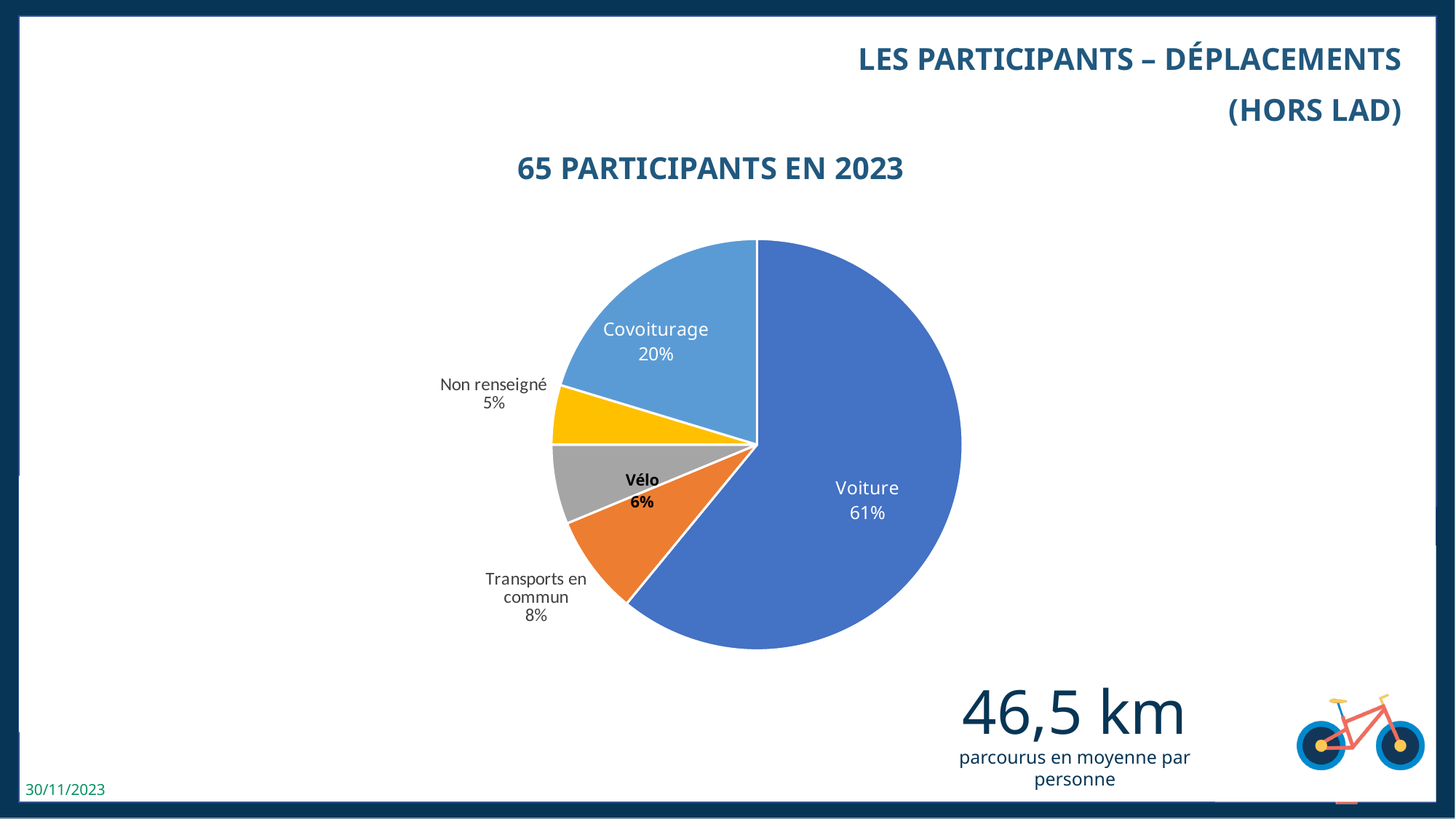
What share of participants used Covoiturage? 20% What share of participants travelled by Voiture? 61% What share of participants is labelled Non renseigné? 5% Which category has the smallest slice of the pie? Non renseigné What is the title shown above the pie chart? 65 PARTICIPANTS EN 2023 Which is larger, the share for Transports en commun or the share for Vélo? Transports en commun What is the difference in percentage points between Voiture and Covoiturage? 41 What share of participants came by Vélo? 6% Which category has the largest slice of the pie? Voiture How many slices does the pie chart have? 5 What share of participants used Transports en commun? 8% What kind of chart is shown on the slide? pie chart